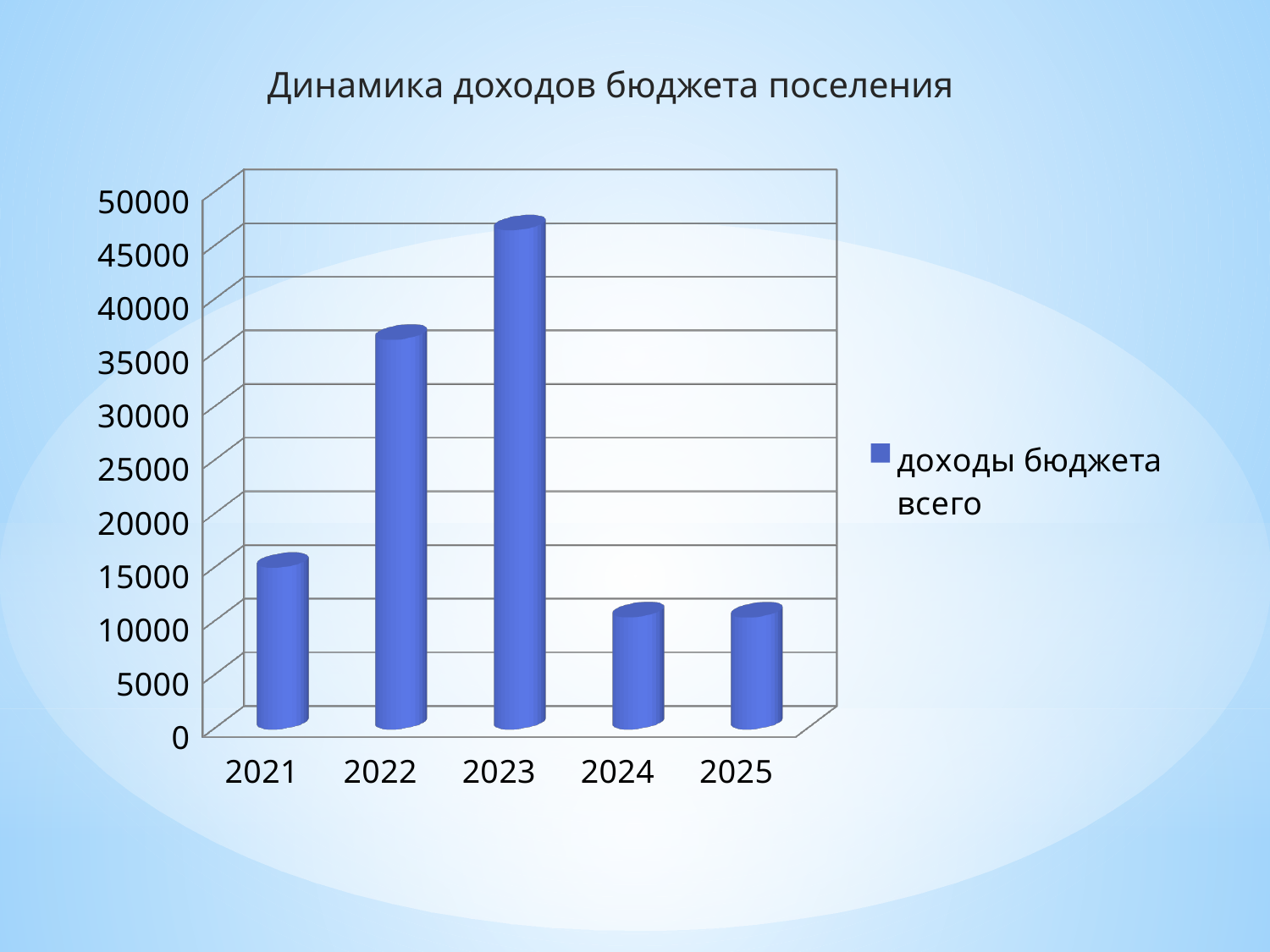
Which is larger, the value for 2022 or the value for 2021? 2022 Is the value for 2022 greater or less than 30000? greater Is the value for 2024 greater or less than 20000? less What is the name of the series shown in the legend? доходы бюджета всего What is the title of the chart? Динамика доходов бюджета поселения Is the value for 2023 greater or less than 40000? greater Which year has the highest value? 2023 How many series does the legend list? 1 How many years are shown on the x axis? 5 What kind of chart is shown on the slide? bar chart Do the values rise or fall from 2021 to 2023? rise